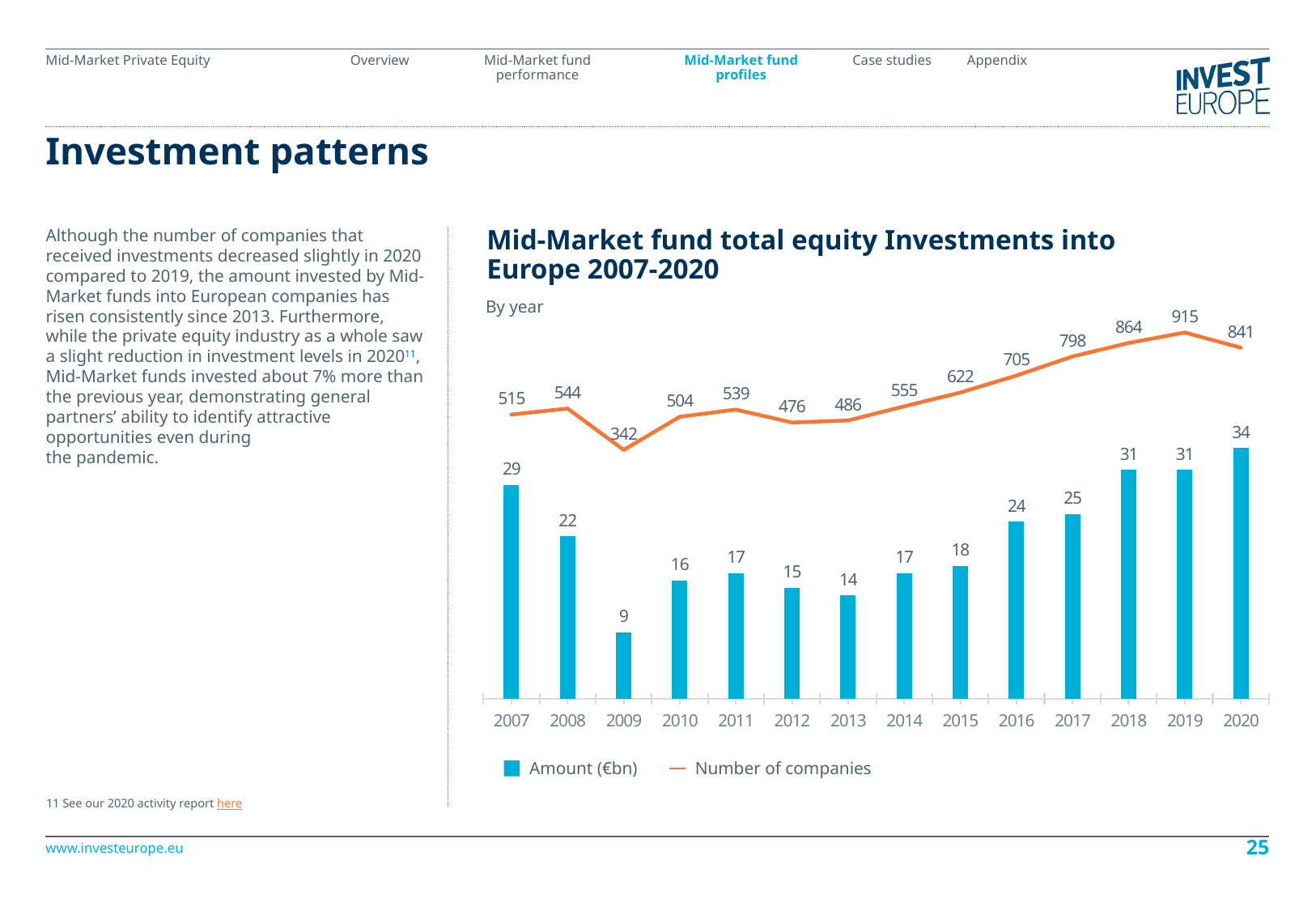
What is the difference in Amount (€bn) between 2020 and 2019? 3 Which year had a larger Amount (€bn), 2007 or 2008? 2007 How many series does the legend list? 2 What was the Number of companies in 2009? 342 Which year had more companies, 2012 or 2013? 2013 Does the Amount (€bn) rise or fall from 2013 to 2020? Rise How many years are shown on the x axis? 14 Which year had the highest Number of companies? 2019 What kind of chart is used to show the Amount (€bn)? Bar chart What was the Amount (€bn) invested in 2020? 34 Which year had the lowest Amount (€bn)? 2009 What is the difference in Number of companies between 2019 and 2020? 74